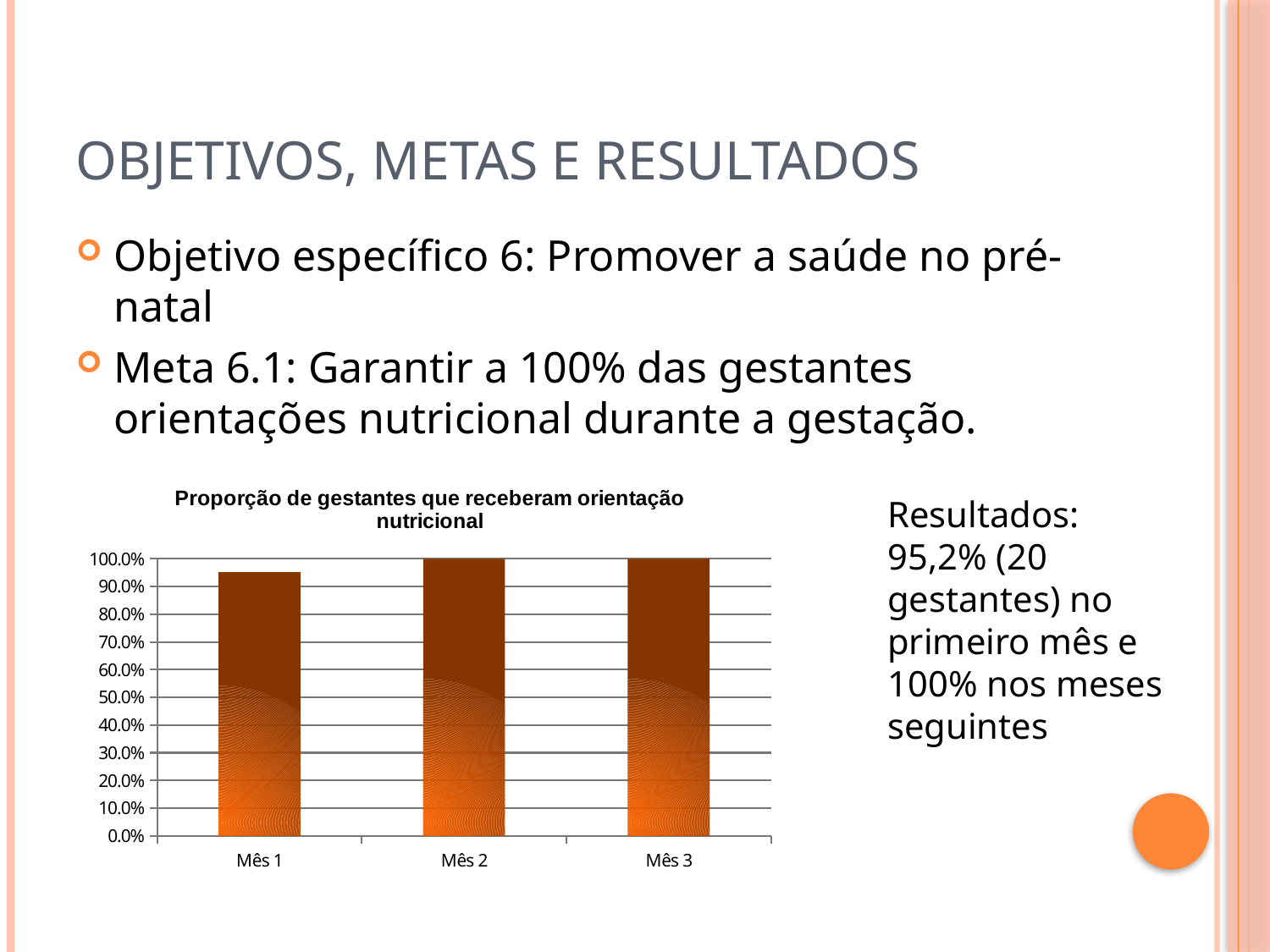
What is the value for Mês 3 on the chart? 100.0% What is the value for Mês 2 on the chart? 100.0% Which is larger, the value for Mês 1 or the value for Mês 2? Mês 2 Is the value for Mês 1 greater or less than 100.0%? less Which month has the lowest value on the chart? Mês 1 Is the value for Mês 1 greater or less than 90.0%? greater What is the title of the chart? Proporção de gestantes que receberam orientação nutricional How many categories (months) are plotted on the chart? 3 What is the highest value shown on the vertical axis of the chart? 100.0% What kind of chart is shown on the slide? bar chart Does the value rise or fall from Mês 1 to Mês 2? rise